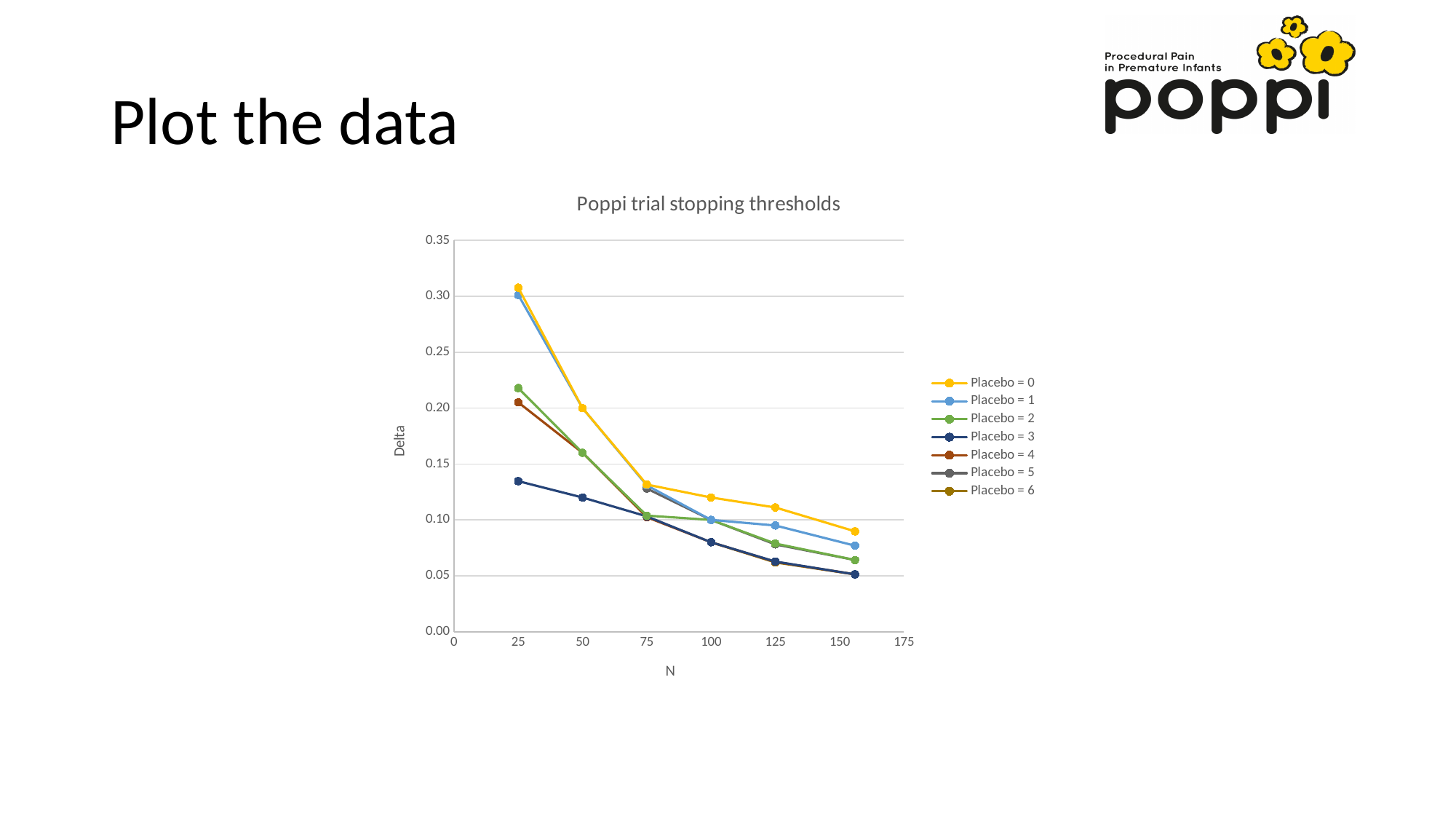
What is the title of the chart? Poppi trial stopping thresholds At N = 50, which is larger: the value for Placebo = 2 or the value for Placebo = 3? Placebo = 2 Do the values for Placebo = 0 rise or fall as N increases? fall How many data points are plotted for the Placebo = 0 series? 6 Is the value for Placebo = 0 at N = 25 greater or less than 0.25? greater Which series has the lowest value at N = 25? Placebo = 3 What kind of chart is shown on the slide? line chart Is the value for Placebo = 3 at N = 25 greater or less than 0.15? less What is the label of the vertical axis? Delta Is the value for Placebo = 2 at N = 25 greater or less than 0.20? greater How many series does the legend list? 7